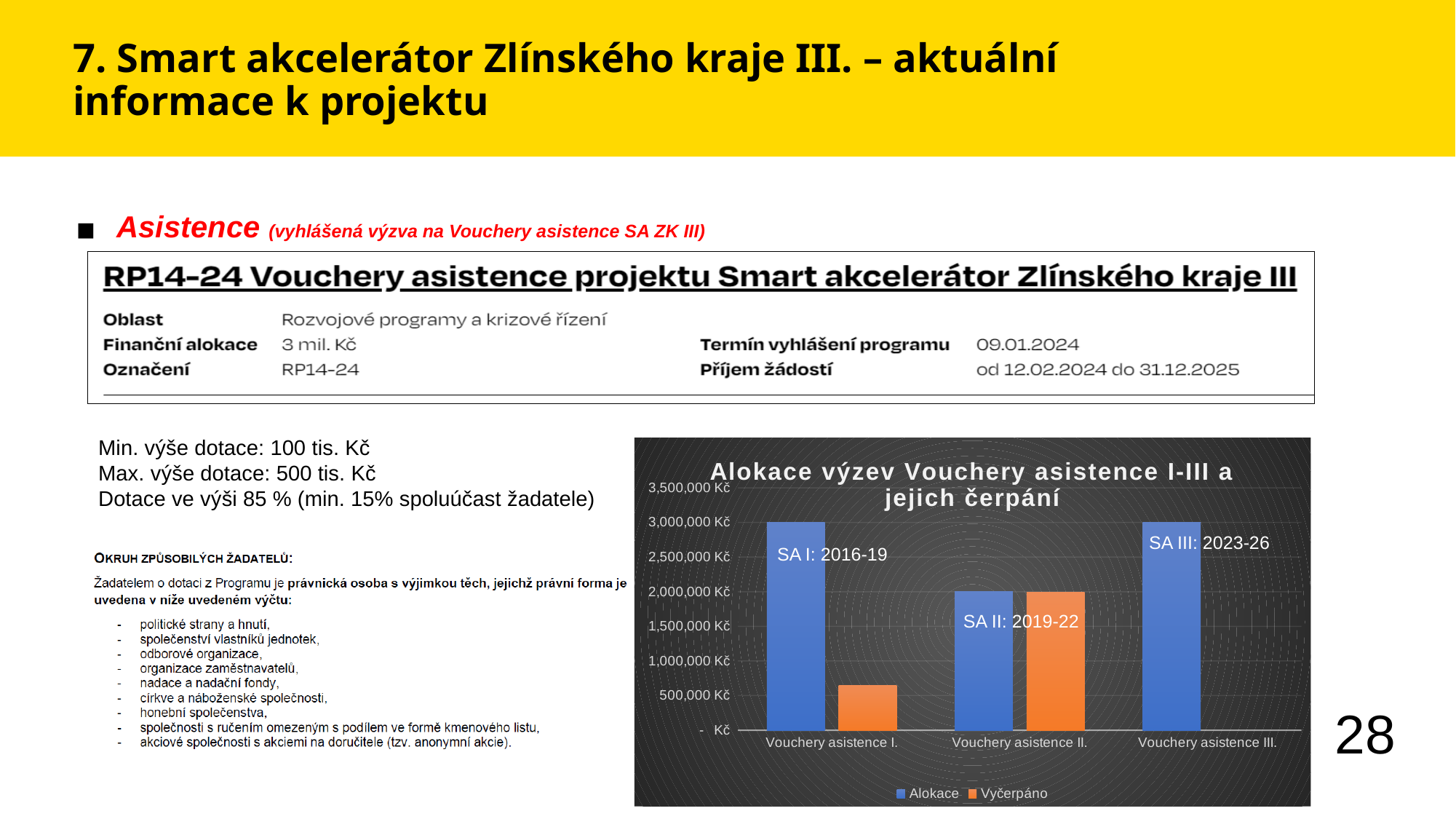
What is the Alokace value for Vouchery asistence II.? 2,000,000 Kč Which is larger for Vouchery asistence I.: Alokace or Vyčerpáno? Alokace How many categories are shown on the x axis of the chart? 3 What is the Alokace value for Vouchery asistence III.? 3,000,000 Kč What kind of chart is shown on the slide? bar chart Which series are listed in the chart legend? Alokace, Vyčerpáno Which category has no Vyčerpáno bar shown? Vouchery asistence III. Which category has the lowest Alokace value? Vouchery asistence II. Is the Vyčerpáno value for Vouchery asistence I. greater or less than 1,000,000 Kč? less What is the title of the chart? Alokace výzev Vouchery asistence I-III a jejich čerpání How many series does the chart legend list? 2